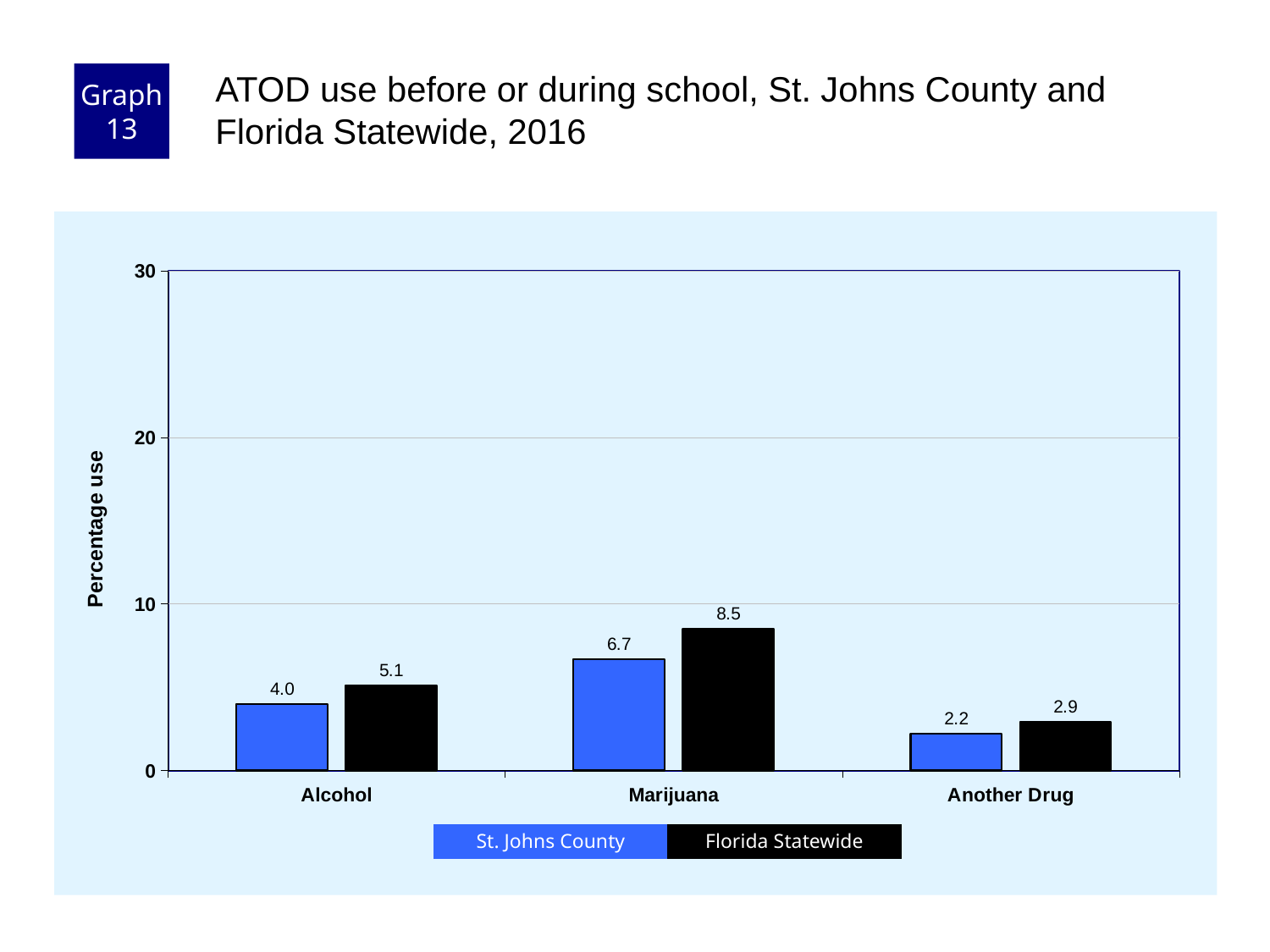
How many categories are shown on the x axis? 3 What is the difference between the Florida Statewide and St. Johns County values for Marijuana? 1.8 Which category has the lowest St. Johns County value? Another Drug Which is larger for Another Drug, St. Johns County or Florida Statewide? Florida Statewide What is the St. Johns County value for Alcohol? 4.0 What is the St. Johns County value for Another Drug? 2.2 What kind of chart is shown on the slide? bar chart Is the Florida Statewide value for Marijuana greater or less than 10? less How many series does the legend list? 2 What is the Florida Statewide value for Marijuana? 8.5 What is the difference between the Florida Statewide and St. Johns County values for Alcohol? 1.1 Which category has the highest Florida Statewide value? Marijuana